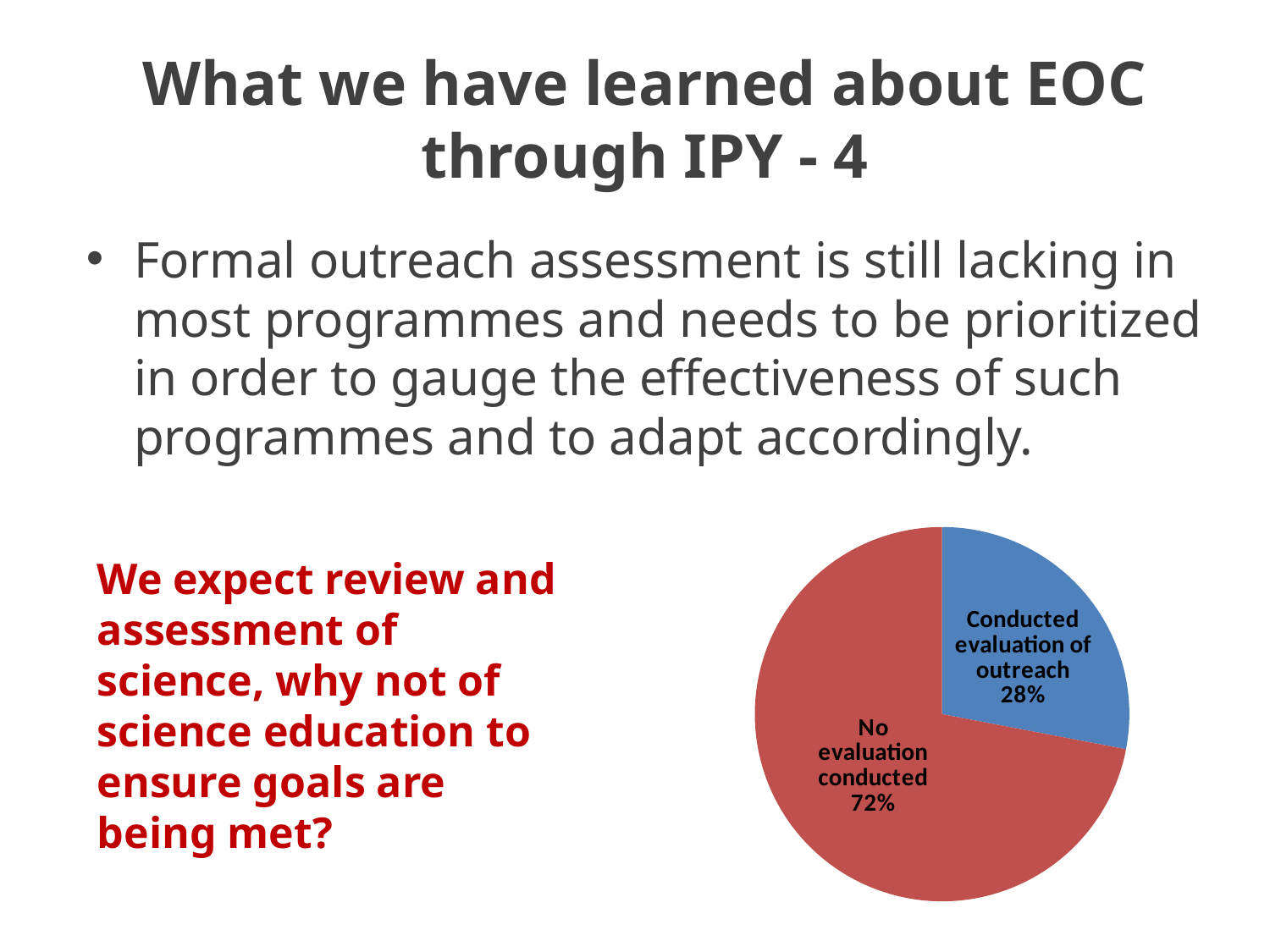
Which slice of the pie is the smallest? Conducted evaluation of outreach What share of the pie is labelled "Conducted evaluation of outreach"? 28% What share of the pie is labelled "No evaluation conducted"? 72% What kind of chart is shown on the slide? pie chart What colour is the "Conducted evaluation of outreach" slice? blue How many slices does the pie chart have? 2 Which slice of the pie is the largest? No evaluation conducted Is the share for "Conducted evaluation of outreach" greater or less than 50%? less Which is larger: the share for "Conducted evaluation of outreach" or the share for "No evaluation conducted"? No evaluation conducted What colour is the "No evaluation conducted" slice? red What is the difference in percentage points between the "No evaluation conducted" slice and the "Conducted evaluation of outreach" slice? 44